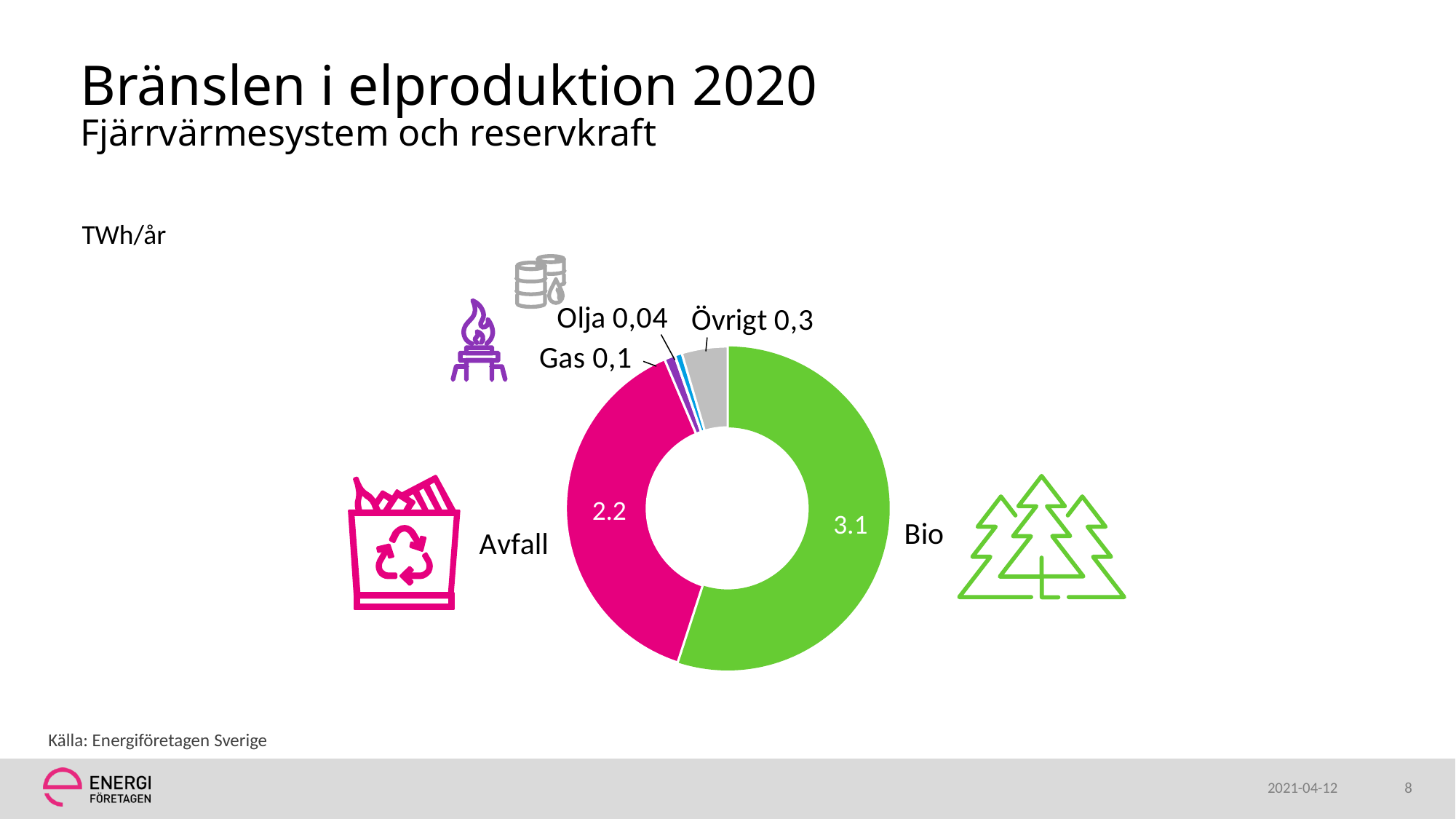
What is the value for Bio in the donut chart? 3.1 Which is larger, the value for Avfall or the value for Övrigt? Avfall Which category has the smallest slice in the donut chart? Olja What is the value for Olja in the donut chart? 0,04 What is the value for Avfall in the donut chart? 2.2 What is the difference between the values for Bio and Avfall? 0.9 What is the value for Övrigt in the donut chart? 0,3 What unit is stated for the values in the chart? TWh/år How many categories are shown in the donut chart? 5 What is the value for Gas in the donut chart? 0,1 Which category has the largest slice in the donut chart? Bio What kind of chart is shown on the slide? Donut (pie) chart